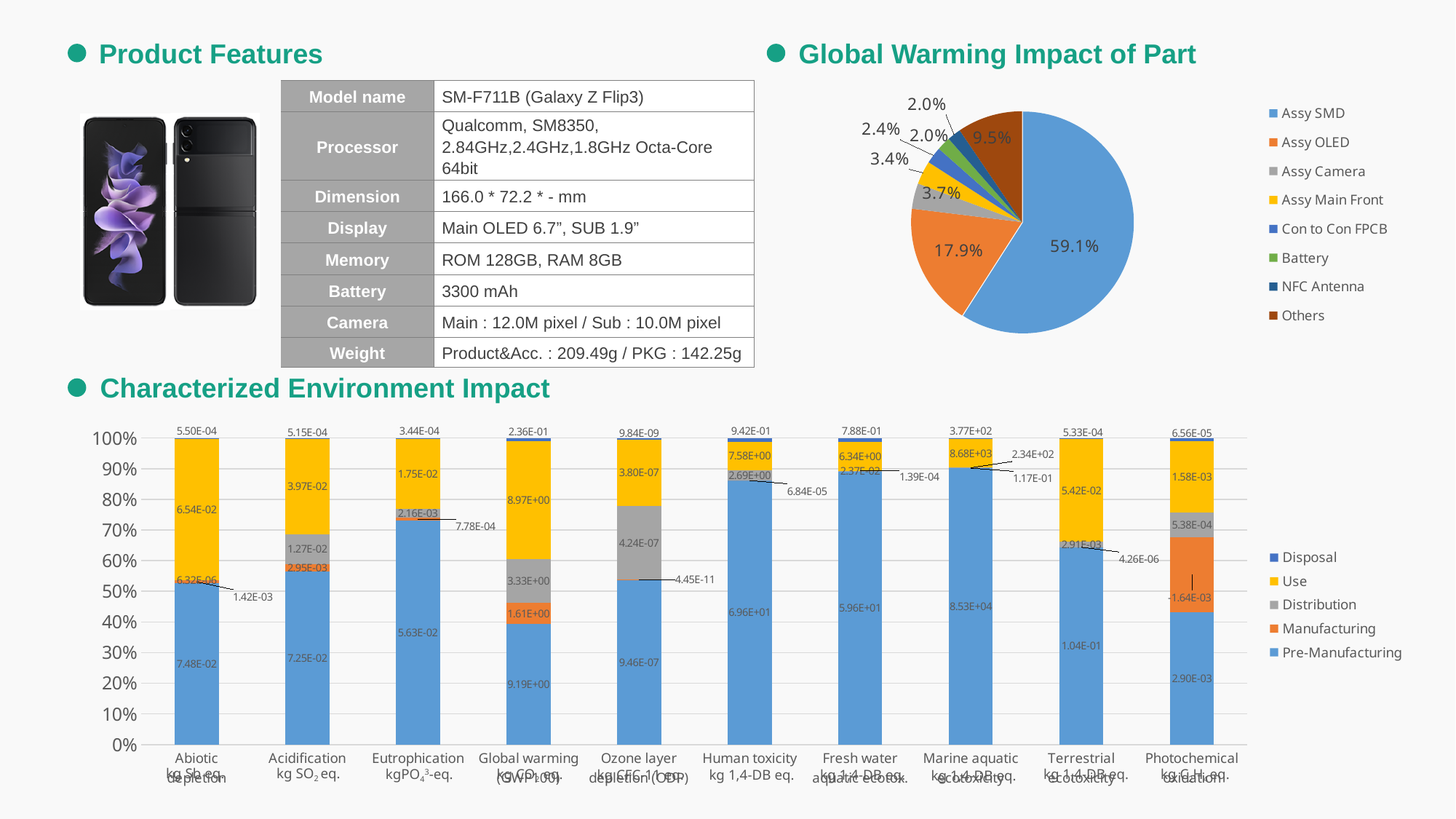
In the Global Warming Impact of Part pie chart, how many percentage points larger is Assy SMD than Assy OLED? 41.2% In the Characterized Environment Impact chart, what is the Pre-Manufacturing value for Global warming? 9.19E+00 In the Characterized Environment Impact chart, what is the Use value for Abiotic depletion? 6.54E-02 In the Characterized Environment Impact chart, how many series does the legend list? 5 What kind of chart is the Characterized Environment Impact chart? Stacked bar chart In the Global Warming Impact of Part pie chart, how many entries does the legend list? 8 In the Characterized Environment Impact chart, how many impact categories are shown on the x axis? 10 In the Global Warming Impact of Part pie chart, which is larger, Assy Camera or Assy Main Front? Assy Camera In the Global Warming Impact of Part pie chart, which part has the largest slice? Assy SMD In the Global Warming Impact of Part pie chart, what share does Others have? 9.5% In the Global Warming Impact of Part pie chart, what share does Assy SMD have? 59.1% In the Global Warming Impact of Part pie chart, what share does Assy OLED have? 17.9%